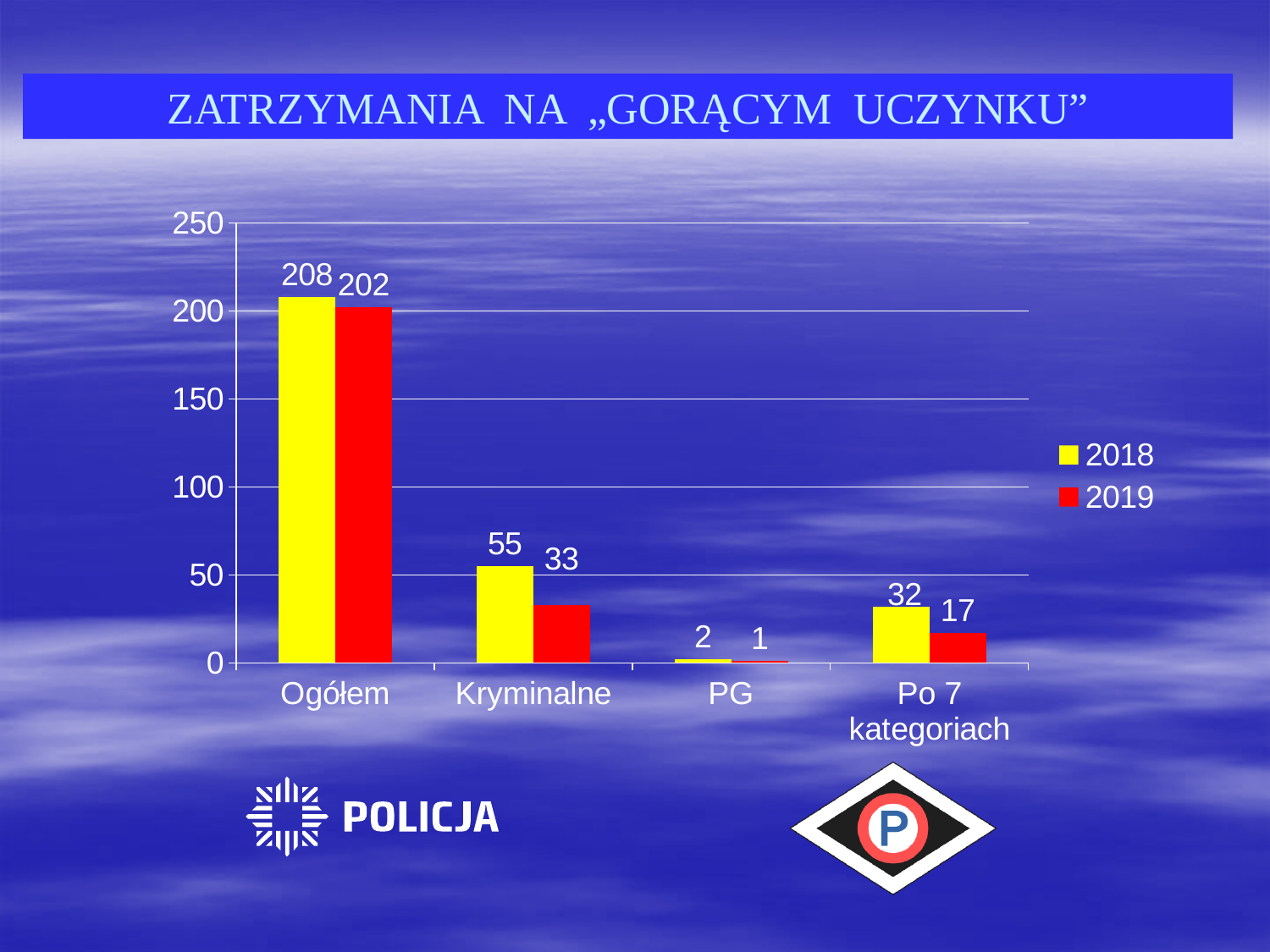
What is the value for PG in 2019? 1 What is the value for Po 7 kategoriach in 2018? 32 Which category has the lowest value in 2018? PG What kind of chart is shown on the slide? bar chart Which category has the highest value in 2019? Ogółem How many series does the legend list? 2 What is the difference between the 2018 and 2019 values for Kryminalne? 22 What is the value for Ogółem in 2018? 208 How many categories are shown on the x axis? 4 What is the difference between the 2018 and 2019 values for Ogółem? 6 What is the value for Kryminalne in 2019? 33 Which is larger: the 2018 value for Po 7 kategoriach or the 2019 value for Kryminalne? 2019 value for Kryminalne